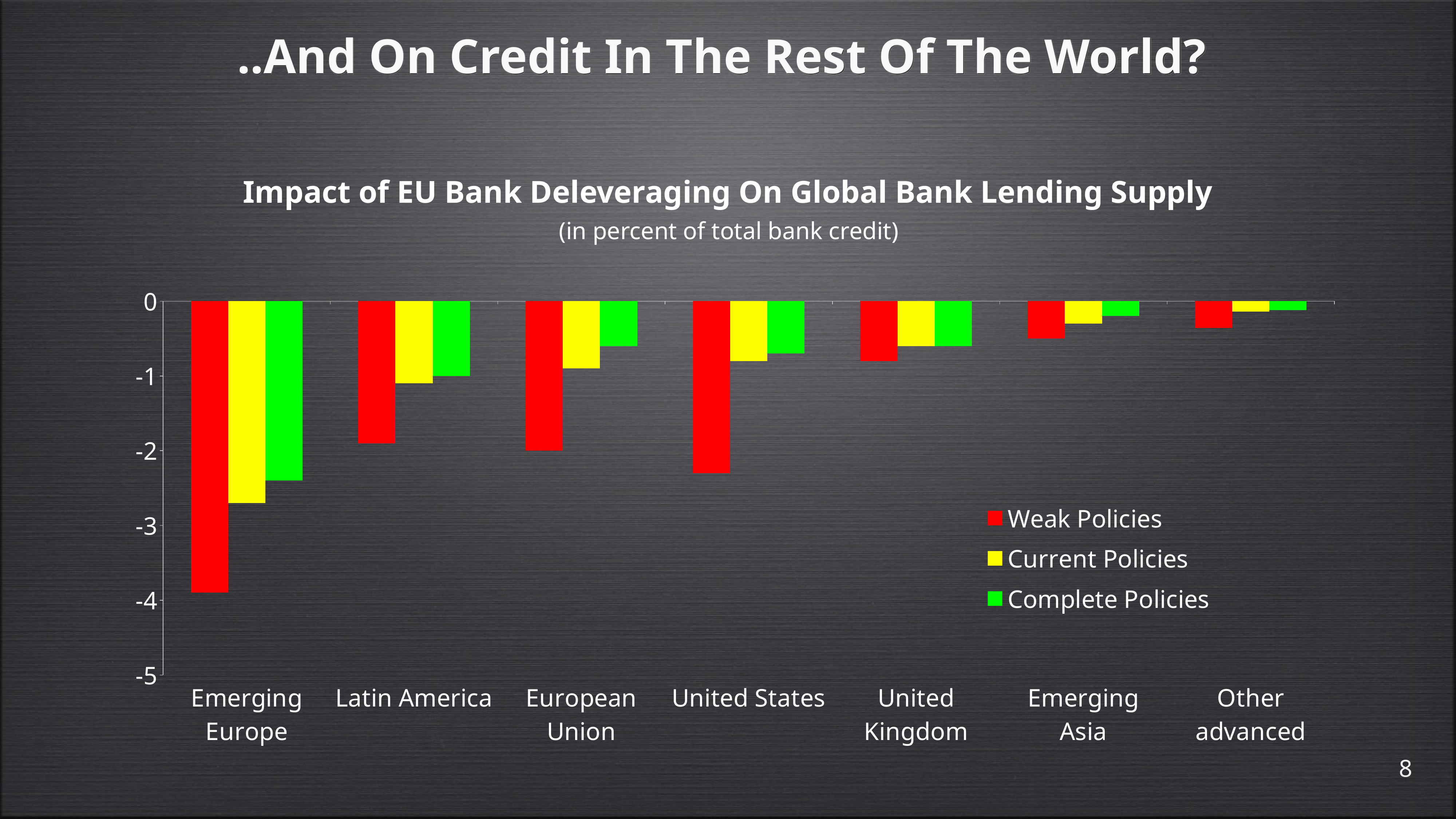
Which colour represents the Current Policies series in the chart? Yellow Which category shows the largest decline (most negative value) under Weak Policies? Emerging Europe For Emerging Europe, which series shows the larger decline: Weak Policies or Complete Policies? Weak Policies What kind of chart is shown on the slide? Bar chart Is the Weak Policies value for United Kingdom greater or less than -1? greater Under Weak Policies, which has the larger decline: United States or European Union? United States Is the Weak Policies value for Emerging Europe greater or less than -3? less How many regions/categories are shown on the x axis of the chart? 7 Is the Current Policies value for Emerging Europe greater or less than -2? less Which category shows the smallest decline under Complete Policies? Other advanced How many series does the chart's legend list? 3